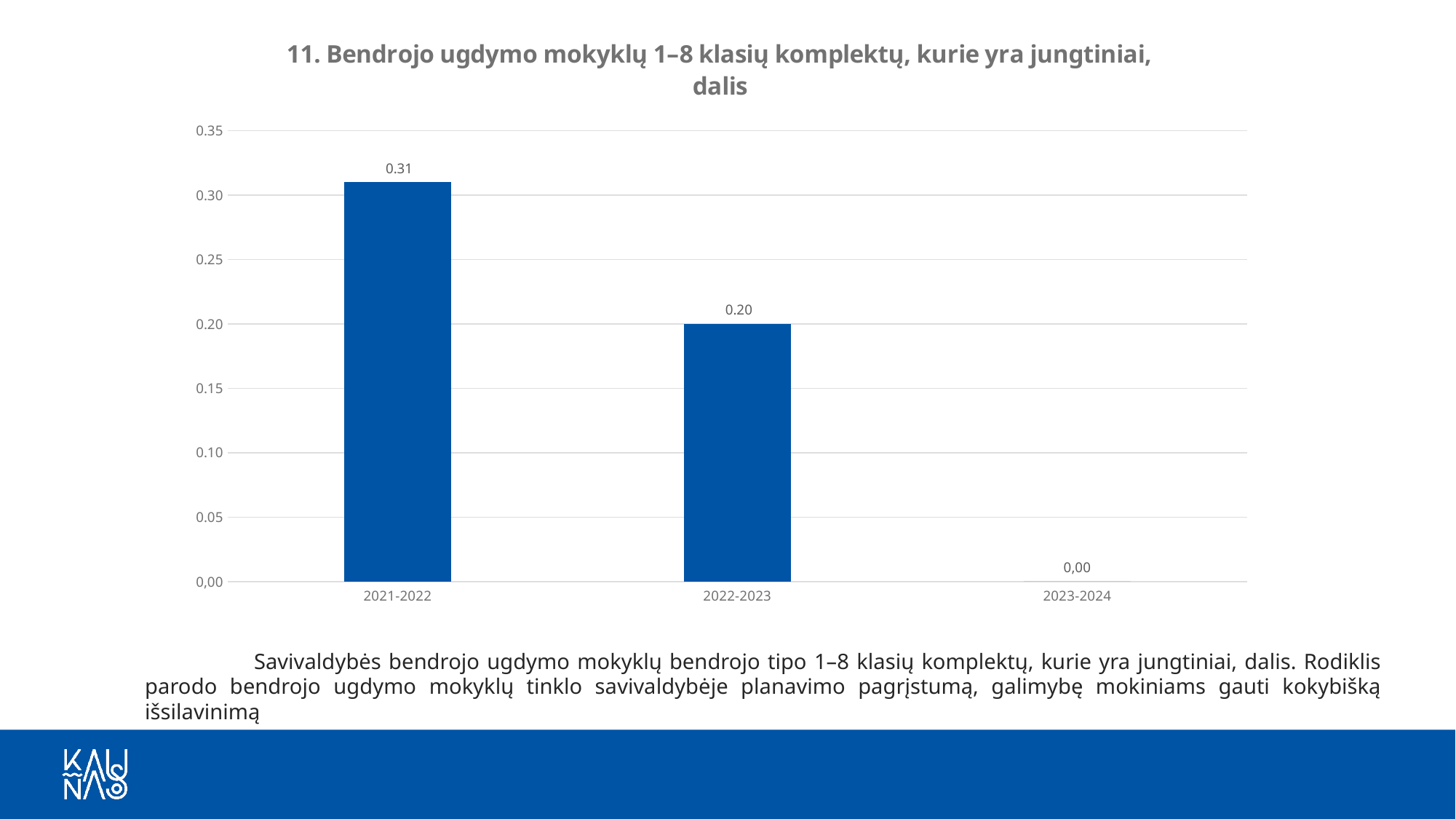
What is the value for 2021-2022? 0.31 Is the value for 2021-2022 greater or less than 0.25? greater Do the values rise or fall from 2021-2022 to 2023-2024? fall What is the highest value shown on the vertical axis? 0.35 What is the value for 2023-2024? 0,00 Which is larger, the value for 2021-2022 or the value for 2022-2023? 2021-2022 Which school year has the highest value? 2021-2022 What kind of chart is shown on the slide? bar chart How many school years are shown on the x axis? 3 What is the difference between the values for 2021-2022 and 2022-2023? 0.11 What is the value for 2022-2023? 0.20 Which school year has the lowest value? 2023-2024